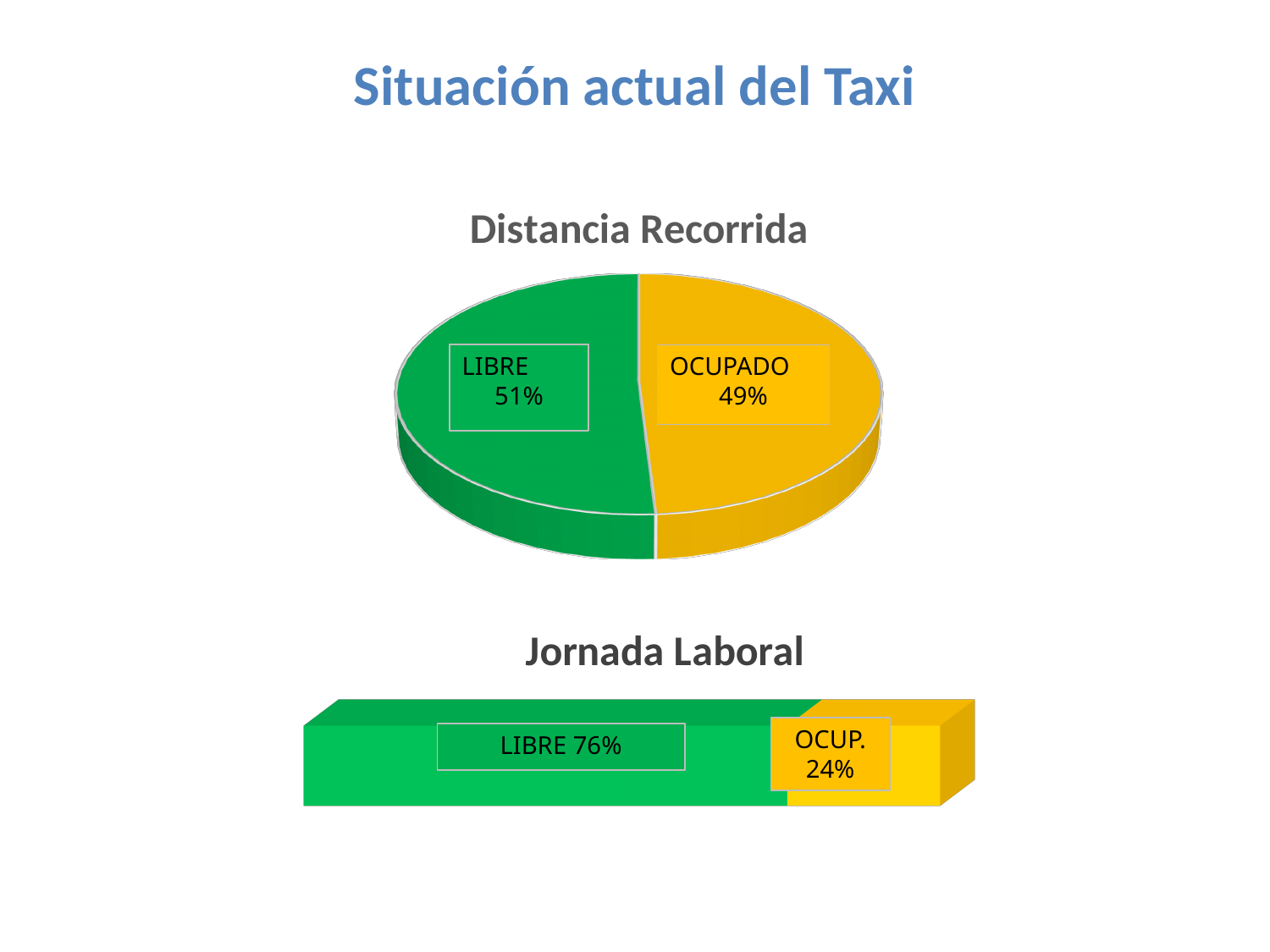
In the 'Jornada Laboral' chart, what is the value for LIBRE? 76% In the 'Distancia Recorrida' chart, what is the difference between the LIBRE and OCUPADO shares? 2% What kind of chart is 'Distancia Recorrida'? Pie chart In the 'Jornada Laboral' chart, which segment is larger, LIBRE or OCUP.? LIBRE In the 'Distancia Recorrida' chart, what share does OCUPADO have? 49% In the 'Jornada Laboral' chart, what is the difference between the LIBRE and OCUP. values? 52% In the 'Jornada Laboral' chart, what is the total of the two segments of the stacked bar? 100% In the 'Distancia Recorrida' chart, what share does LIBRE have? 51% In the 'Jornada Laboral' chart, what is the value for OCUP.? 24% In the 'Distancia Recorrida' chart, what colour is the OCUPADO slice? Yellow In the 'Distancia Recorrida' chart, which slice is larger, LIBRE or OCUPADO? LIBRE How many slices does the 'Distancia Recorrida' pie chart have? 2